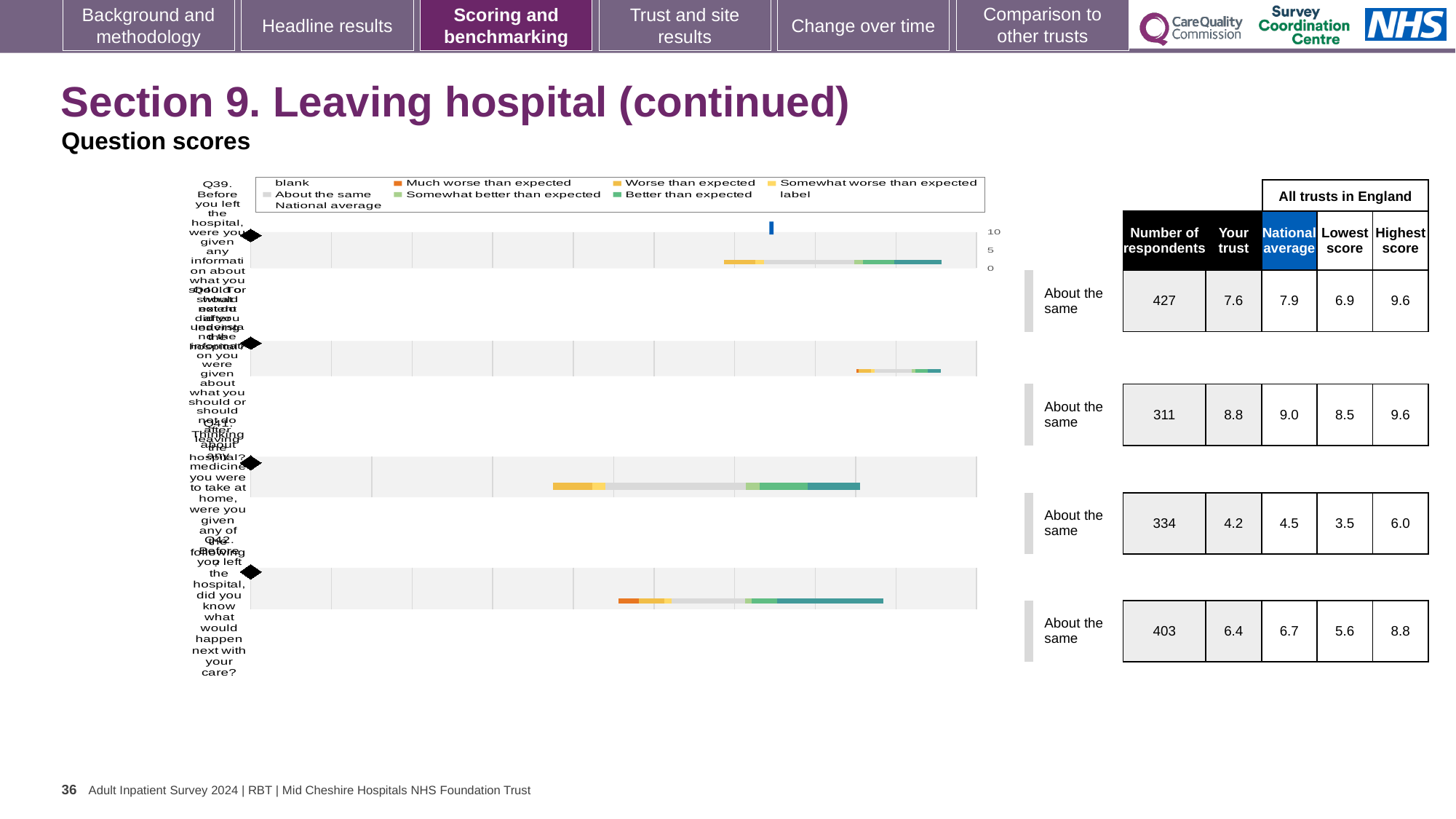
In the table beside the chart, what is the 'Your trust' score for the first question (Q39)? 7.6 What kind of chart is shown on the slide? bar chart In the table beside the chart, what is the national average for the last question (Q42)? 6.7 What benchmark category is shown beside every question bar in the chart? About the same How many entries does the chart legend list? 9 How many question bars are plotted in the chart? 4 What colour does the legend use for 'Better than expected'? teal In the table beside the chart, what is the number of respondents for the first question (Q39)? 427 Which row in the table has the lowest 'Your trust' score? the third row (4.2) For the last question (Q42), is the 'Your trust' score higher or lower than the national average? lower Which row in the table has the highest 'Your trust' score? the second row (8.8) What is the difference between the national average and the 'Your trust' score for the first question (Q39)? 0.3